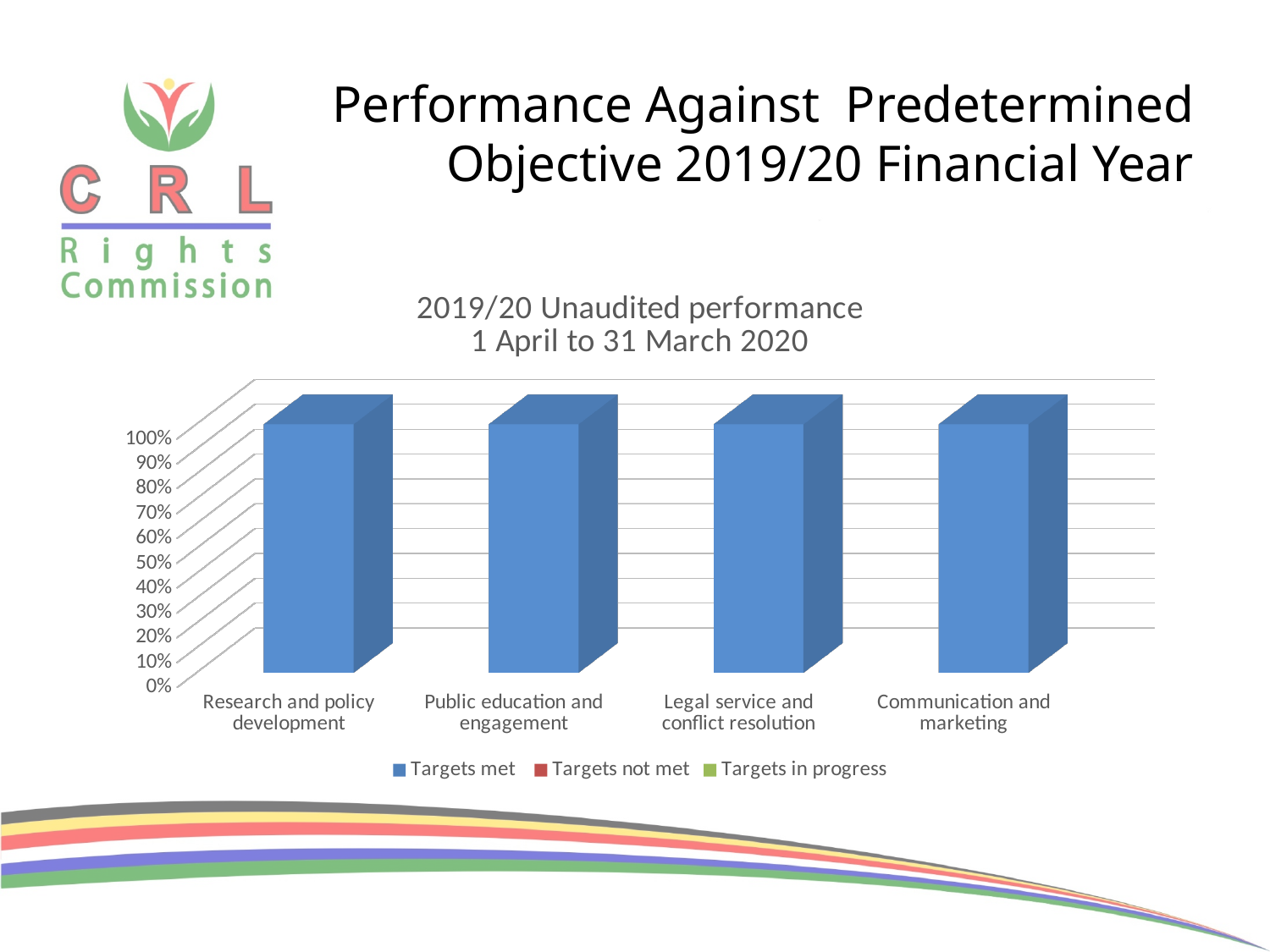
What is the Targets met value for Research and policy development? 100% Is the value for Public education and engagement greater or less than 80%? greater How many categories are shown along the x axis of the chart? 4 Is the value for Communication and marketing greater or less than 50%? greater How many series does the chart's legend list? 3 What are the three entries in the chart's legend? Targets met, Targets not met, Targets in progress What is the Targets met value for Legal service and conflict resolution? 100% What kind of chart is shown on the slide? Bar chart What is the highest value shown on the vertical axis? 100% Do the values rise, fall, or stay the same across the four categories on the x axis? Stay the same What is the title of the chart? 2019/20 Unaudited performance 1 April to 31 March 2020 Is the value for Research and policy development greater or less than 90%? greater